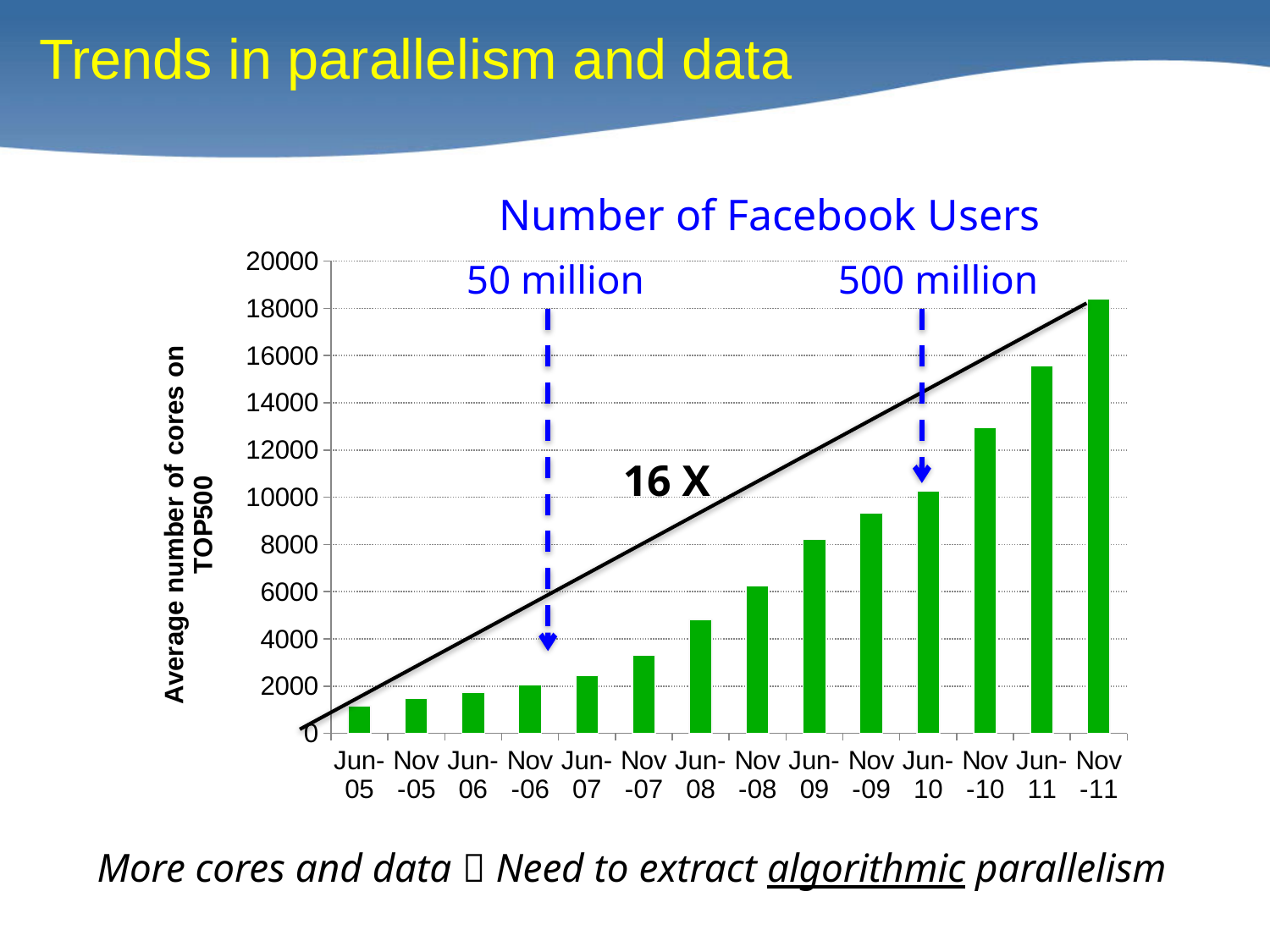
Is the value for Jun-08 greater or less than 4000? greater Do the bar values rise or fall from Jun-05 to Nov-11? rise Which time period has the lowest average number of cores on TOP500? Jun-05 What growth factor is annotated next to the black trend line on the chart? 16 X What kind of chart is shown on the slide? bar chart Which is larger, the value for Jun-09 or the value for Nov-08? Jun-09 How many bars (time periods) are plotted on the x axis? 14 Is the value for Jun-10 greater or less than 12000? less Which time period has the highest average number of cores on TOP500? Nov-11 What is the label on the y axis of the chart? Average number of cores on TOP500 Is the value for Nov-11 greater or less than 18000? greater